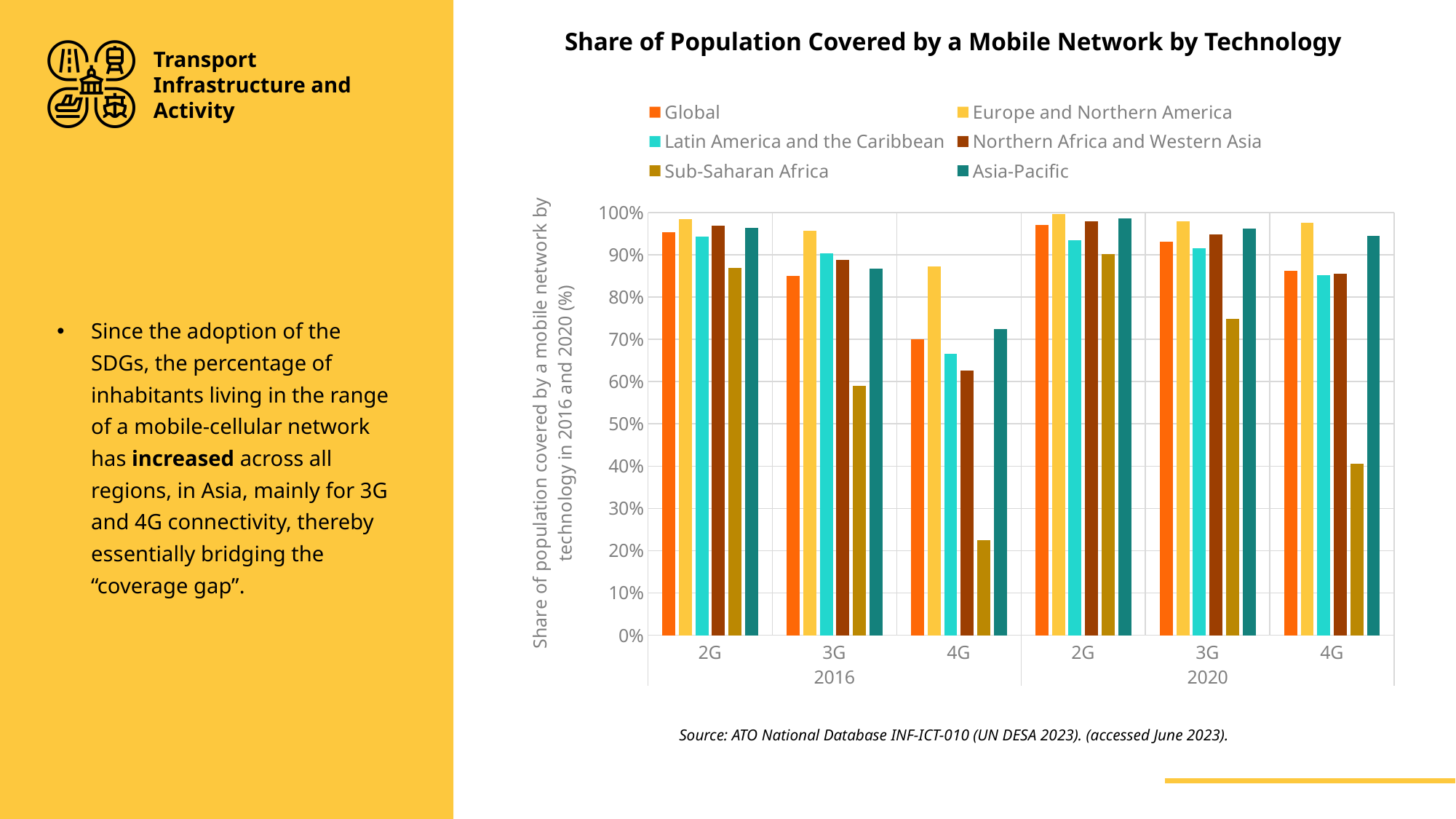
Is the value for Sub-Saharan Africa 4G in 2020 greater or less than 50%? less How many technology category groups are shown along the x axis? 6 Which is larger for 4G in 2020: Asia-Pacific or Latin America and the Caribbean? Asia-Pacific Is the value for Sub-Saharan Africa 4G in 2016 greater or less than 30%? less Is the value for Global 3G in 2016 greater or less than 80%? greater Which is larger for 3G in 2016: Europe and Northern America or Sub-Saharan Africa? Europe and Northern America What kind of chart is shown on the slide? Bar chart How many series does the legend list? 6 Does Sub-Saharan Africa's 4G coverage rise or fall from 2016 to 2020? rise Which region has the highest 4G coverage in 2016? Europe and Northern America What is the title of the chart? Share of Population Covered by a Mobile Network by Technology Which region has the lowest 4G coverage in 2016? Sub-Saharan Africa